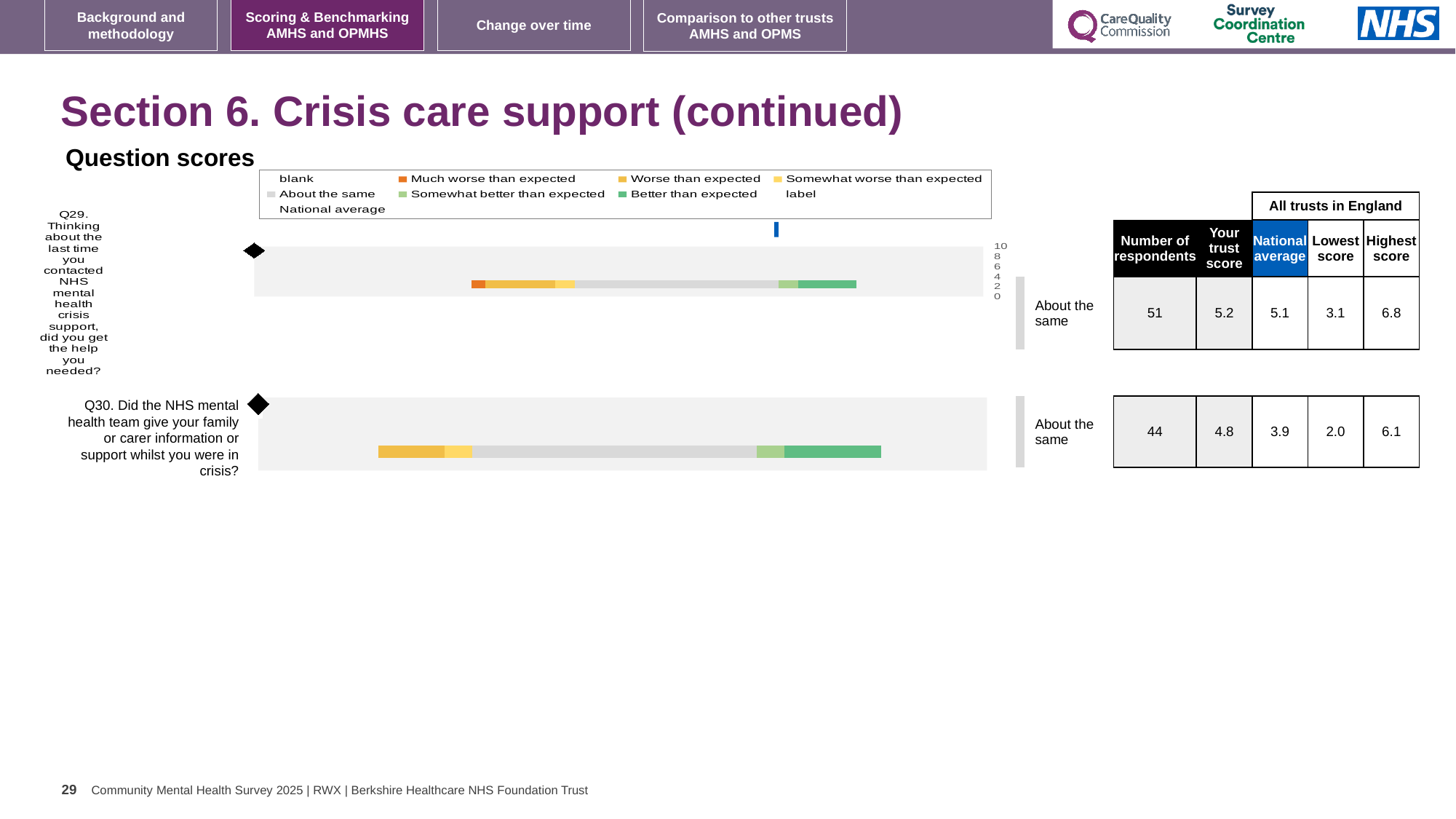
What is the difference between the trust score and the national average for Q30? 0.9 Which question has the higher highest score among all trusts in England, Q29 or Q30? Q29 Which is larger for Q29, the trust score or the national average? trust score What is the lowest score among all trusts in England for Q29? 3.1 How many questions (bars) are plotted on the slide? 2 What is the national average for Q30? 3.9 What is the difference between the highest and lowest scores for Q29? 3.7 What kind of chart is used to show the question scores for Q29 and Q30? bar chart How many respondents answered Q30? 44 What is the trust score for Q29? 5.2 Which benchmark category does the trust's score for Q30 fall into? About the same What colour represents 'Better than expected' in the legend? green